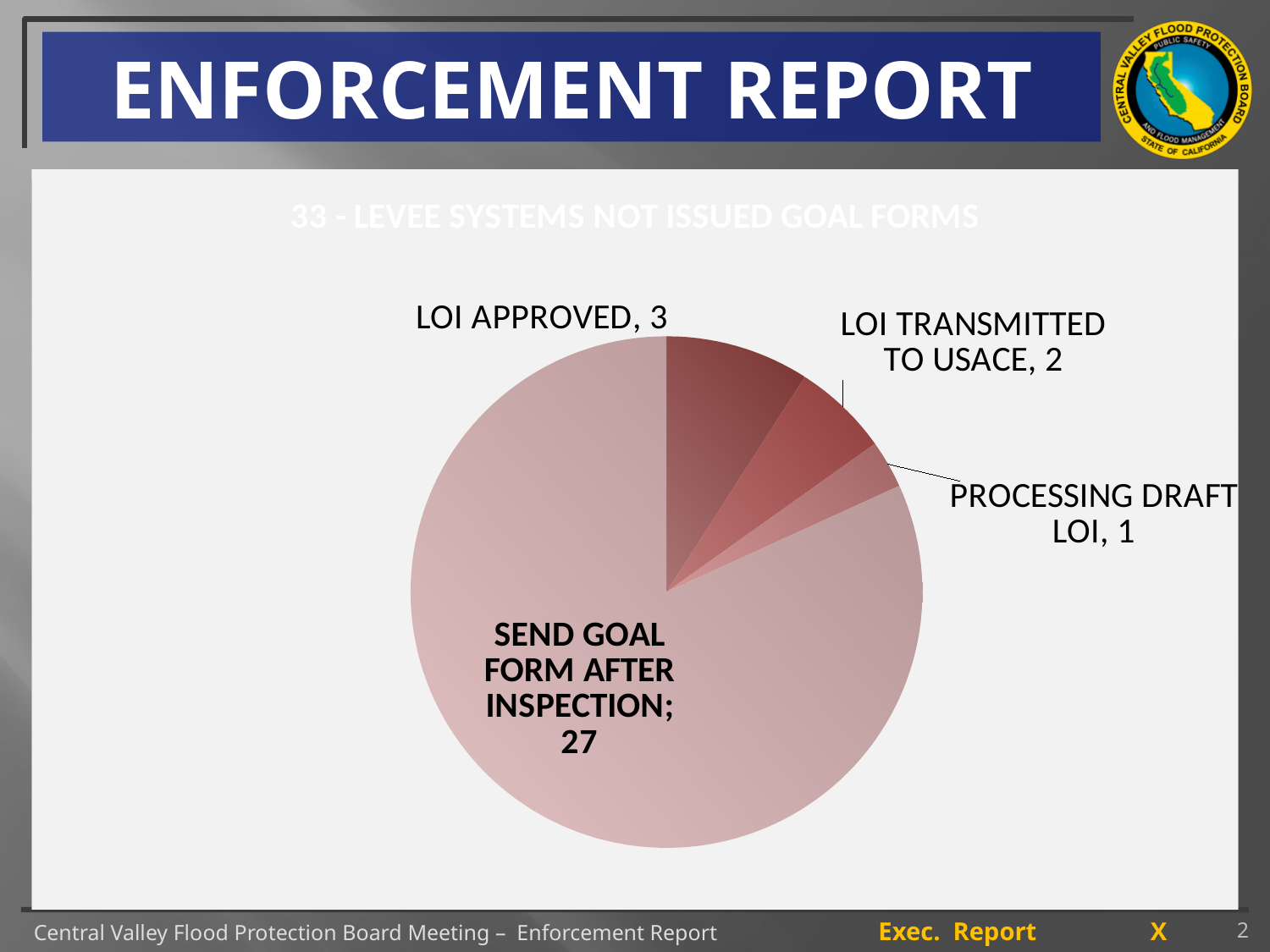
What kind of chart is shown on the slide? pie chart What is the title of the pie chart? 33 - LEVEE SYSTEMS NOT ISSUED GOAL FORMS What is the difference between the values for SEND GOAL FORM AFTER INSPECTION and LOI APPROVED? 24 What is the total of all the slices in the pie chart? 33 Which category has the largest slice of the pie? SEND GOAL FORM AFTER INSPECTION How many categories are shown in the pie chart? 4 What is the value for LOI TRANSMITTED TO USACE? 2 What is the value for LOI APPROVED? 3 What is the value for PROCESSING DRAFT LOI? 1 Which category has the smallest slice of the pie? PROCESSING DRAFT LOI What is the value for SEND GOAL FORM AFTER INSPECTION? 27 Which is larger, LOI APPROVED or LOI TRANSMITTED TO USACE? LOI APPROVED